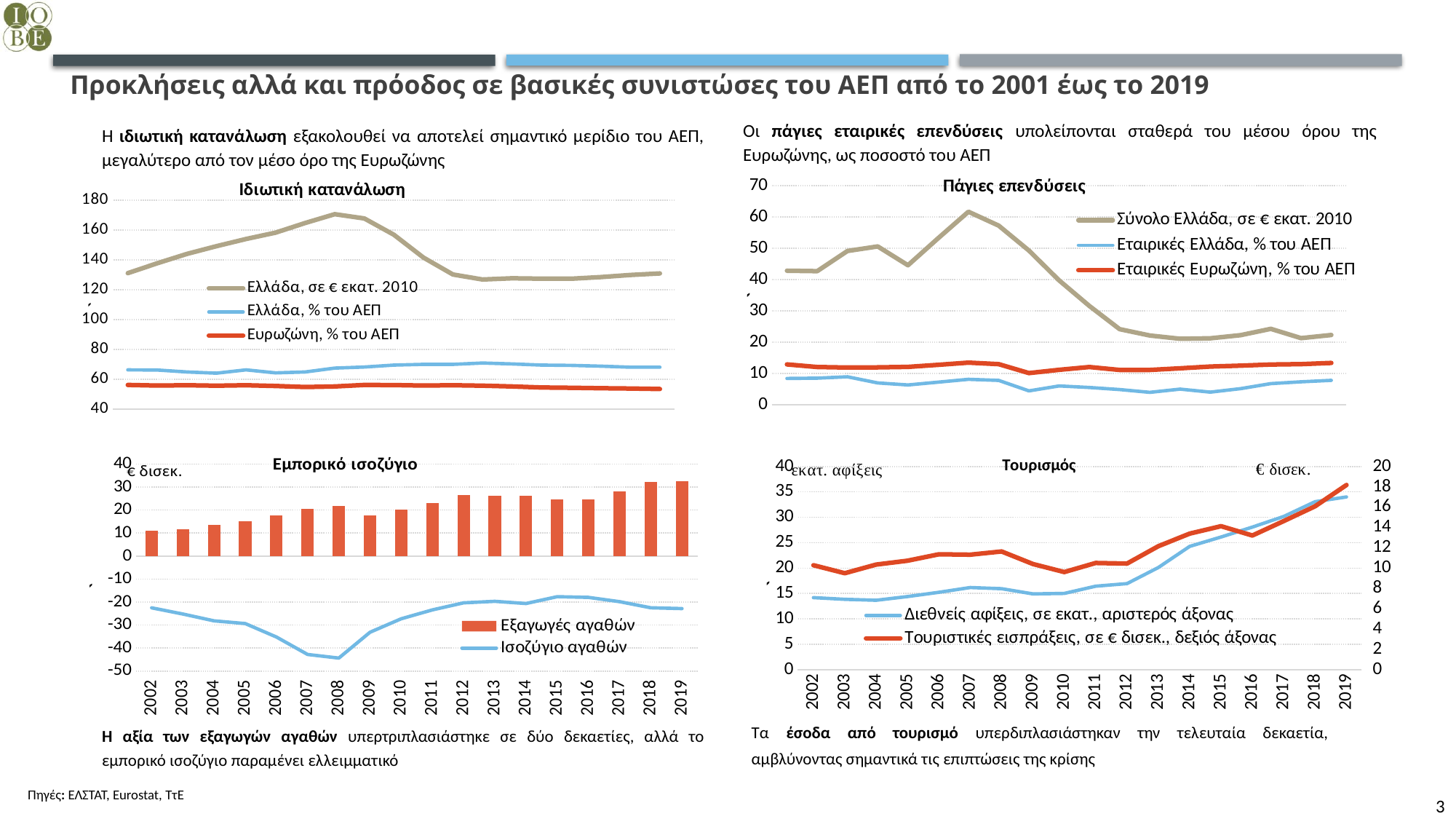
In the 'Εμπορικό ισοζύγιο' chart, is the value of 'Ισοζύγιο αγαθών' for 2008 greater or less than -40? less In the 'Πάγιες επενδύσεις' chart, which series is drawn in red? Εταιρικές Ευρωζώνης, % του ΑΕΠ In the 'Τουρισμός' chart, is the value of 'Διεθνείς αφίξεις' for 2002 greater or less than 20 on the left axis? less In the 'Εμπορικό ισοζύγιο' chart, which series is shown as bars? Εξαγωγές αγαθών In the 'Εμπορικό ισοζύγιο' chart, how many years are shown on the x axis? 18 In the 'Εμπορικό ισοζύγιο' chart, is the value of 'Εξαγωγές αγαθών' for 2002 greater or less than 20? less In the 'Τουρισμός' chart, do the 'Τουριστικές εισπράξεις' values rise or fall from 2012 to 2019? rise What kind of chart is the 'Ιδιωτική κατανάλωση' chart? line chart How many series does the legend of the 'Ιδιωτική κατανάλωση' chart list? 3 How many series does the legend of the 'Πάγιες επενδύσεις' chart list? 3